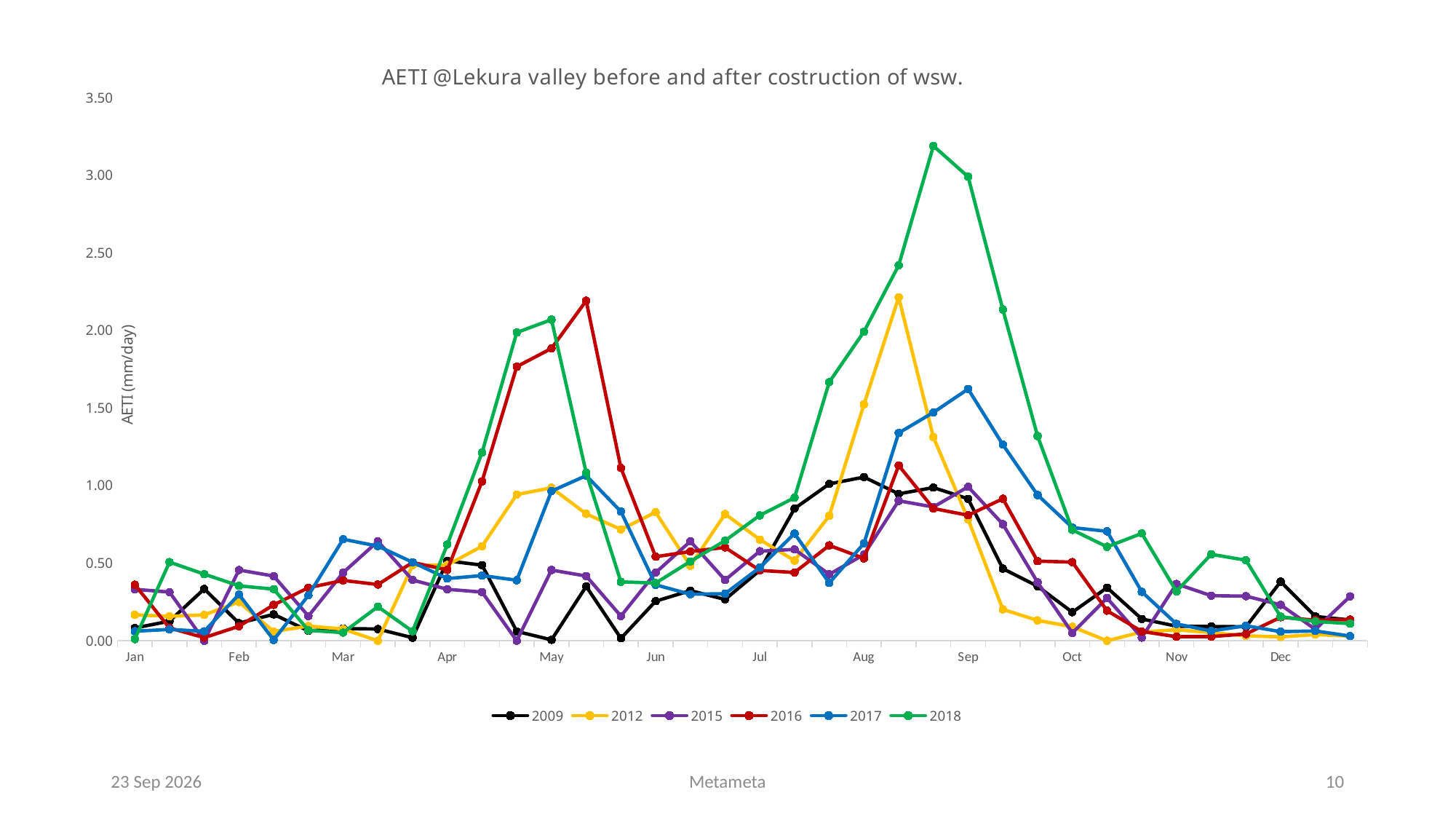
What is the label of the vertical axis? AETI (mm/day) Which series has the higher peak, 2012 or 2015? 2012 Is the highest value of the 2009 series greater or less than 1.50? less How many series does the legend list? 6 How many months are labelled along the x axis? 12 Is the highest value of the 2018 series greater or less than 3.00? greater Which series has the higher peak, 2018 or 2016? 2018 Which series reaches the highest value on the chart? 2018 Is the highest value of the 2016 series greater or less than 2.00? greater What kind of chart is shown on the slide? line chart What is the title of the chart? AETI @Lekura valley before and after costruction of wsw.